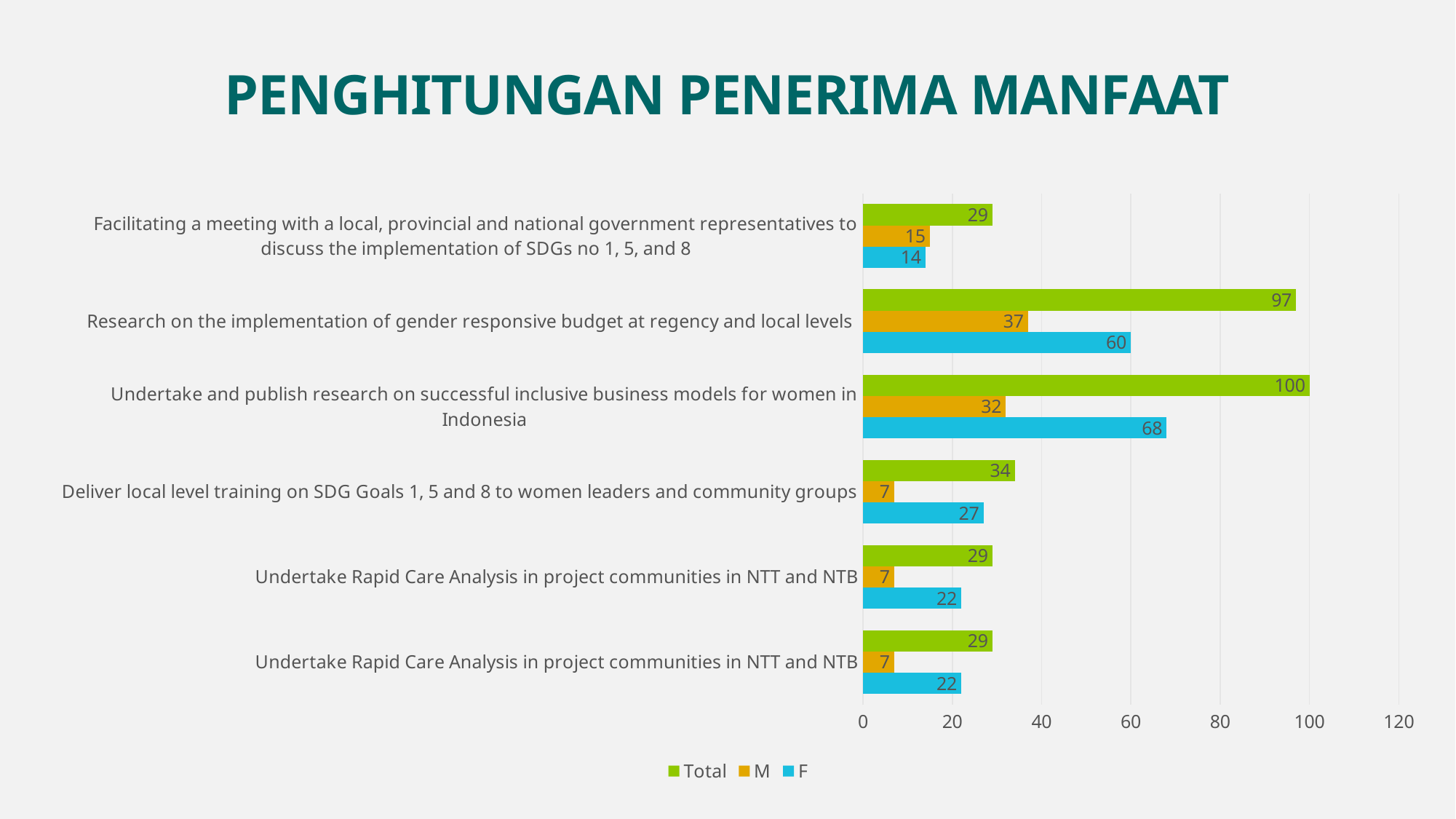
What is the title of the slide? PENGHITUNGAN PENERIMA MANFAAT What is the F value for "Undertake and publish research on successful inclusive business models for women in Indonesia"? 68 What is the F value for "Facilitating a meeting with a local, provincial and national government representatives to discuss the implementation of SDGs no 1, 5, and 8"? 14 How many series does the legend list? 3 What is the Total value for "Research on the implementation of gender responsive budget at regency and local levels"? 97 Which category has the lowest F value? Facilitating a meeting with a local, provincial and national government representatives to discuss the implementation of SDGs no 1, 5, and 8 What kind of chart is shown on the slide? bar chart Which is larger, the M value for "Facilitating a meeting with a local, provincial and national government representatives to discuss the implementation of SDGs no 1, 5, and 8" or the M value for "Deliver local level training on SDG Goals 1, 5 and 8 to women leaders and community groups"? Facilitating a meeting with a local, provincial and national government representatives to discuss the implementation of SDGs no 1, 5, and 8 What is the difference between the F and M values for "Research on the implementation of gender responsive budget at regency and local levels"? 23 How many categories are shown on the y axis of the chart? 6 What is the M value for "Deliver local level training on SDG Goals 1, 5 and 8 to women leaders and community groups"? 7 Which category has the highest Total value? Undertake and publish research on successful inclusive business models for women in Indonesia